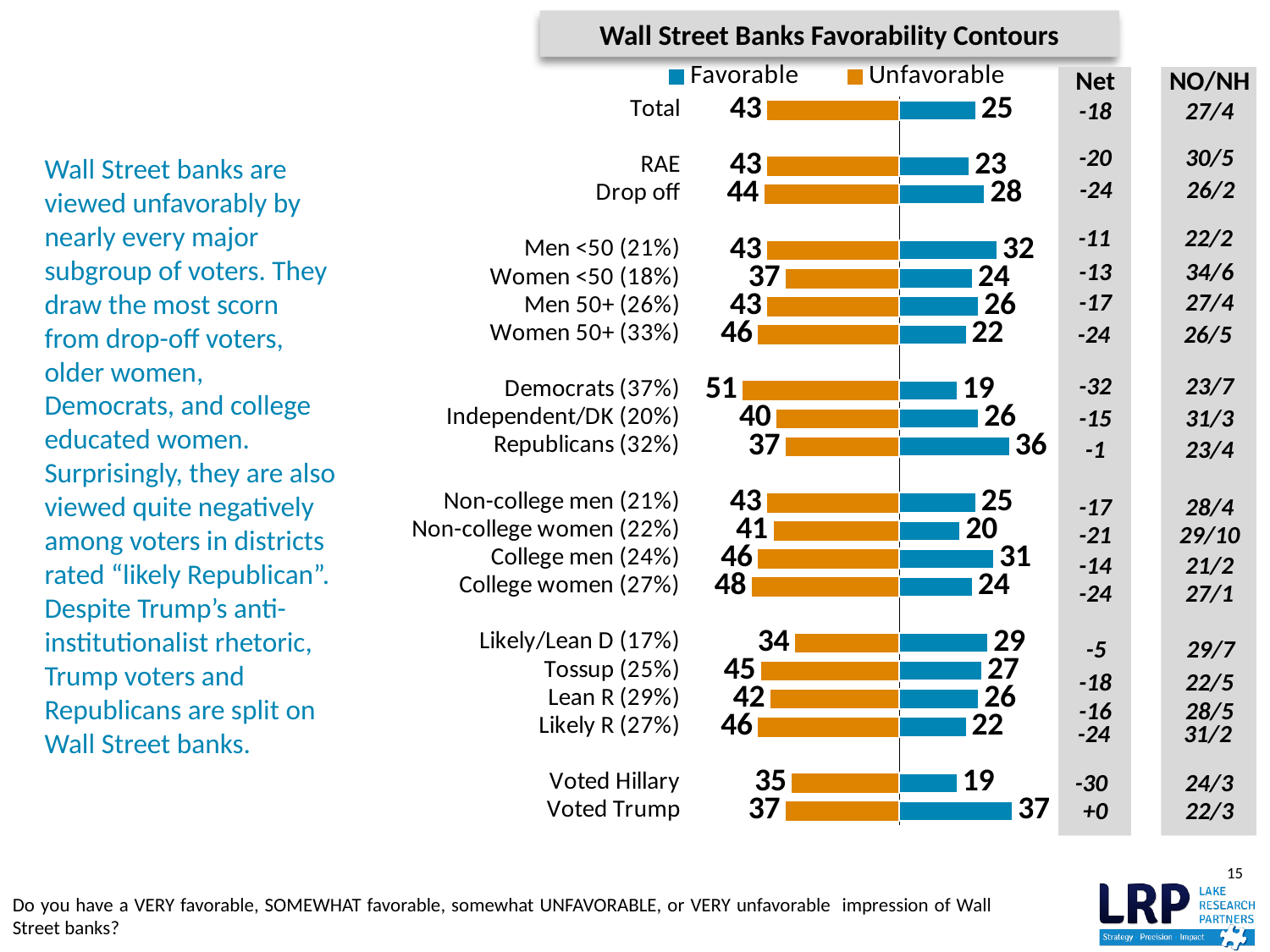
What kind of chart is shown on the slide? Bar chart How many series does the chart's legend list? 2 What is the Favorable value for Voted Hillary? 19 Which category has the highest Unfavorable value? Democrats (37%) What is the Favorable value for Republicans (32%)? 36 Which colour represents the Favorable series in the chart? Blue What is the difference between the Unfavorable and Favorable values for Democrats (37%)? 32 What is the Unfavorable value for College women (27%)? 48 What is the Unfavorable value for Total? 43 Which is larger for Men <50 (21%): the Favorable value or the Unfavorable value? Unfavorable How many categories are plotted in the chart? 20 What is the title of the chart? Wall Street Banks Favorability Contours